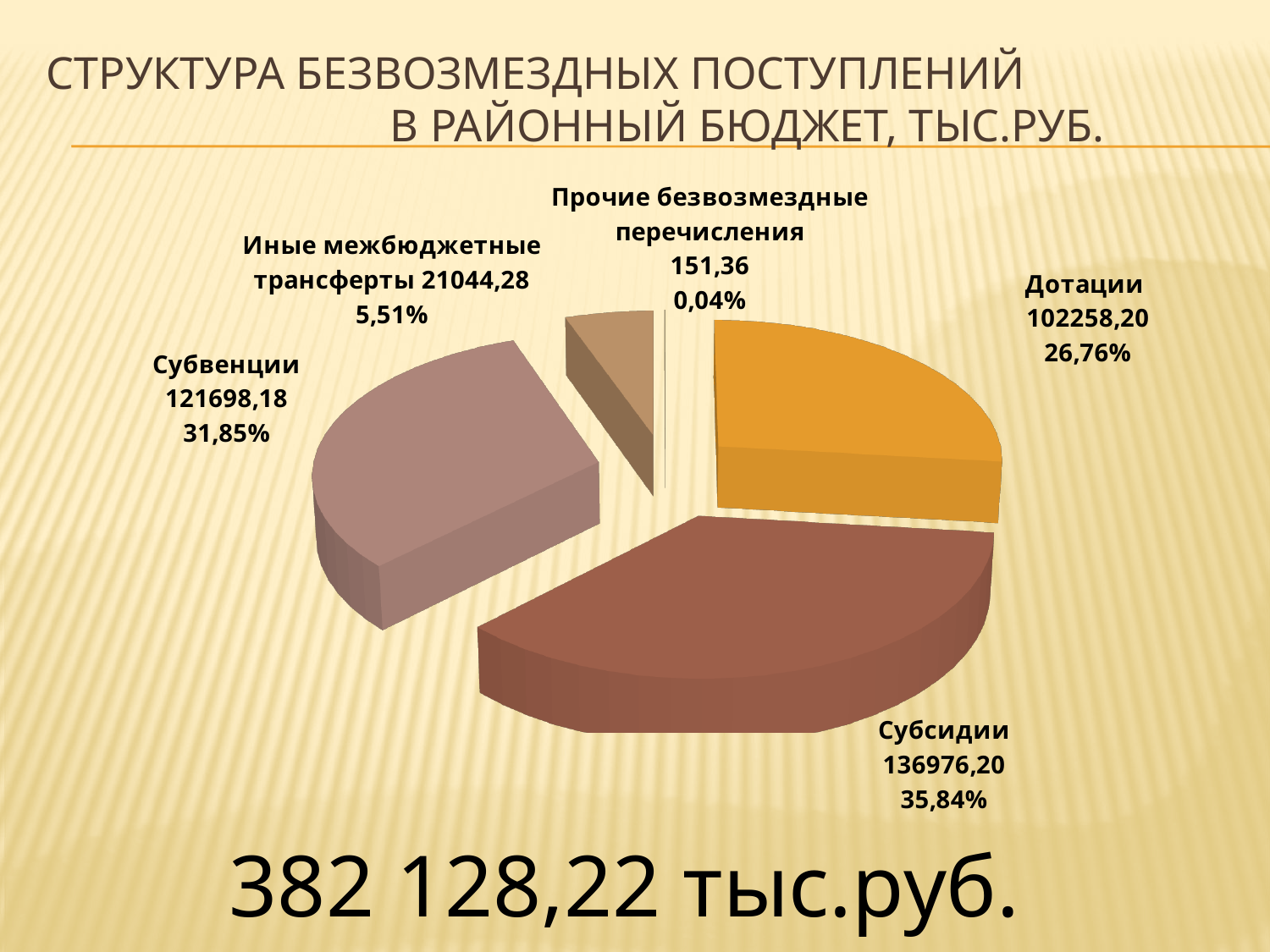
Which is larger, the value for Субвенции or the value for Дотации? Субвенции Which category has the smallest slice of the pie? Прочие безвозмездные перечисления What share of the pie does Иные межбюджетные трансферты represent? 5,51% What kind of chart is shown on the slide? Pie chart Which category has the largest slice of the pie? Субсидии What is the value for Дотации? 102258,20 What share of the pie does Субвенции represent? 31,85% What is the difference between the values for Субсидии and Субвенции? 15278,02 What total amount is printed below the chart? 382 128,22 тыс.руб. How many categories are shown in the pie chart? 5 What is the value for Субсидии? 136976,20 What is the value for Прочие безвозмездные перечисления? 151,36